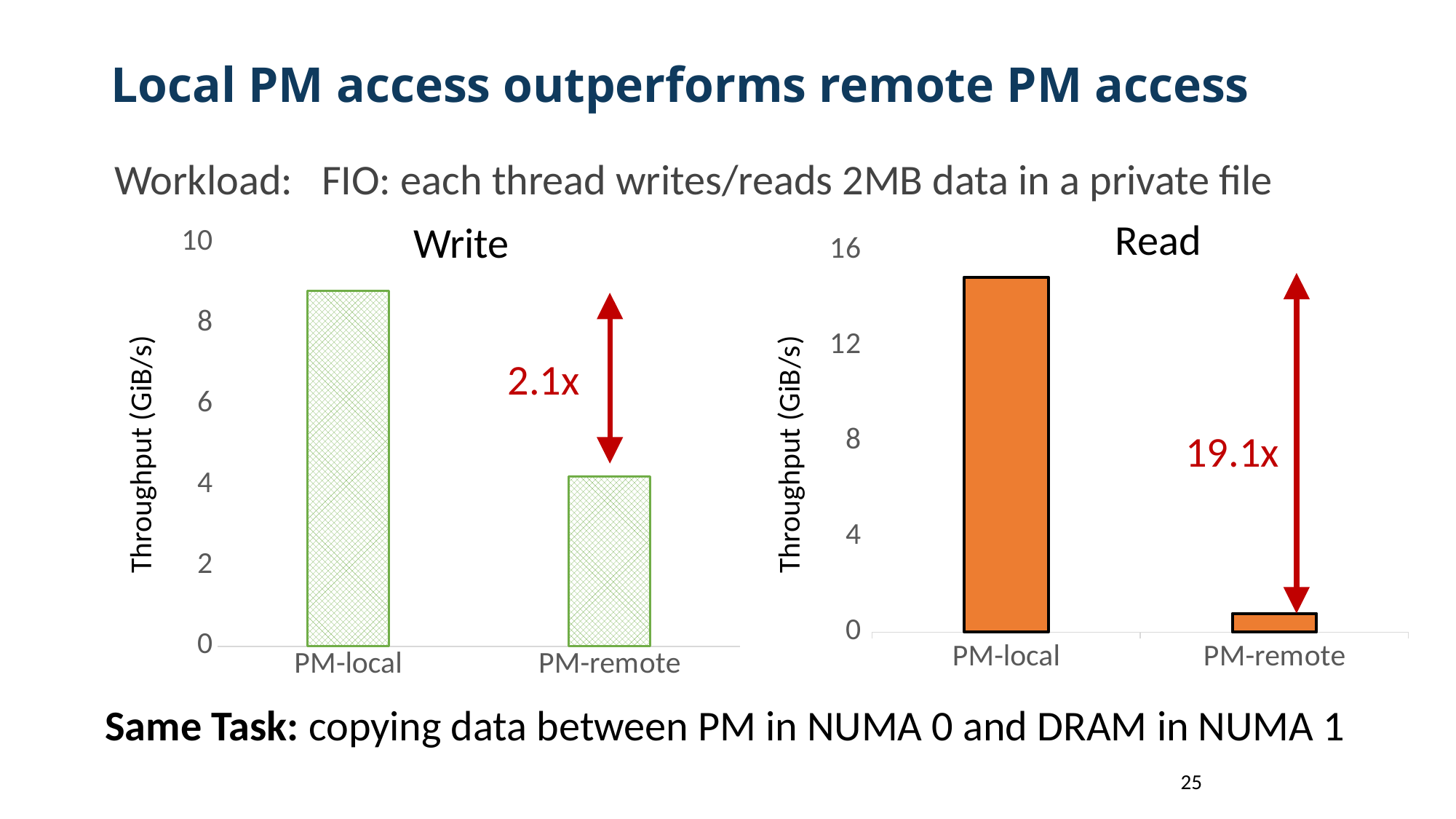
In the Read chart, which category has the lowest throughput? PM-remote In the Write chart, is the value for PM-local greater or less than 8? greater What kind of chart is the Write chart? bar chart What is the highest tick value on the y-axis of the Read chart? 16 What is the y-axis label of the Write chart? Throughput (GiB/s) In the Read chart, is the value for PM-local greater or less than 12? greater How many categories does the Read chart show? 2 In the Write chart, is the value for PM-remote greater or less than 6? less In the Write chart, which category has the highest throughput? PM-local In the Read chart, which is larger, PM-local or PM-remote? PM-local What speedup factor is annotated between PM-local and PM-remote in the Read chart? 19.1x